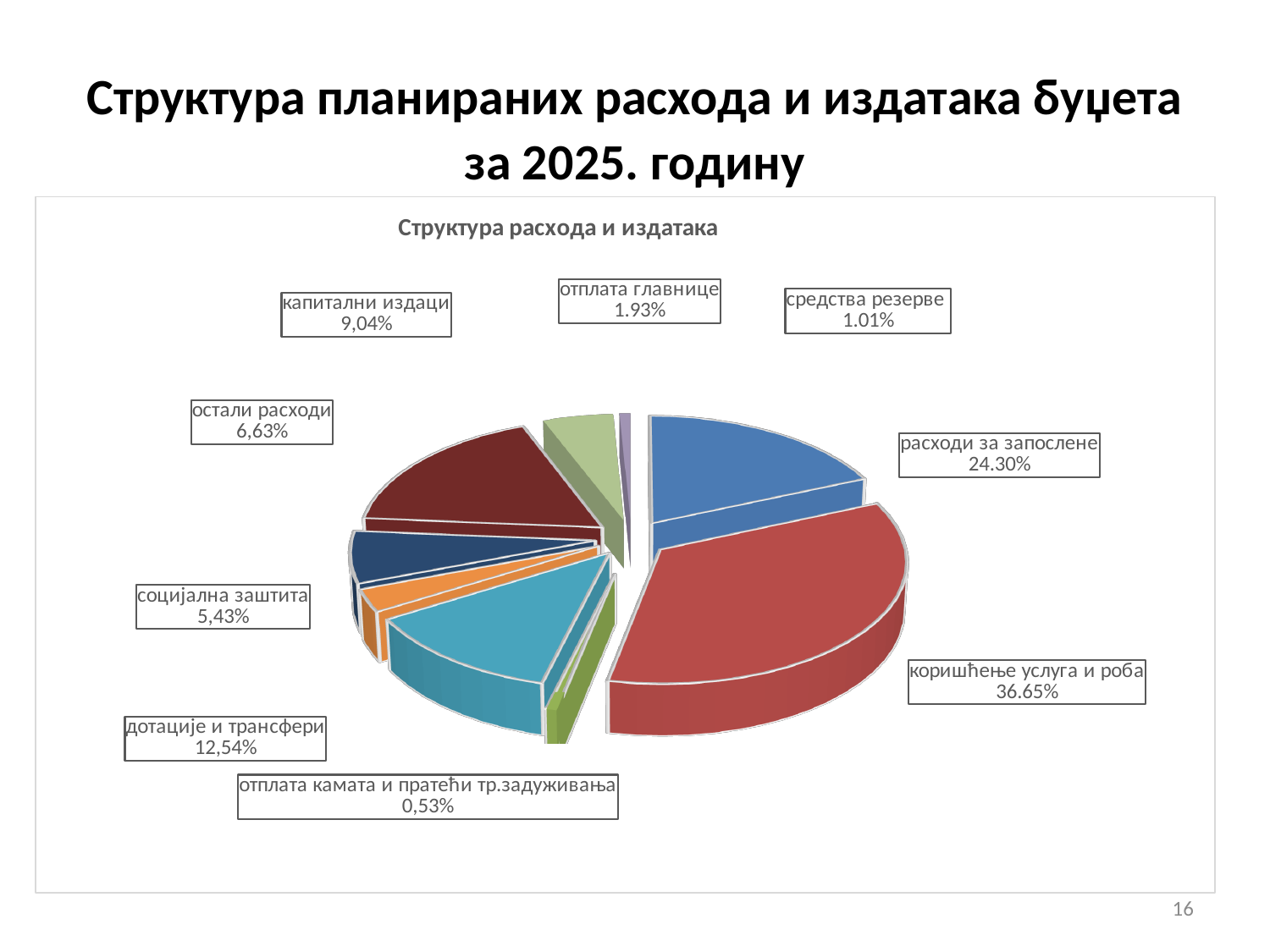
What percentage is shown for расходи за запослене? 24.30% What is the difference between the shares of капитални издаци and остали расходи? 2,41% What is the title of the chart? Структура расхода и издатака How many slices does the pie chart have? 9 What percentage is shown for дотације и трансфери? 12,54% What share of the pie is labelled for коришћење услуга и роба? 36.65% Which has a larger share: капитални издаци or остали расходи? капитални издаци What percentage is shown for отплата камата и пратећи тр.задуживања? 0,53% Which category has the smallest share of the pie? отплата камата и пратећи тр.задуживања What type of chart is shown on the slide? pie chart What percentage is shown for средства резерве? 1.01% Which category has the largest share of the pie? коришћење услуга и роба